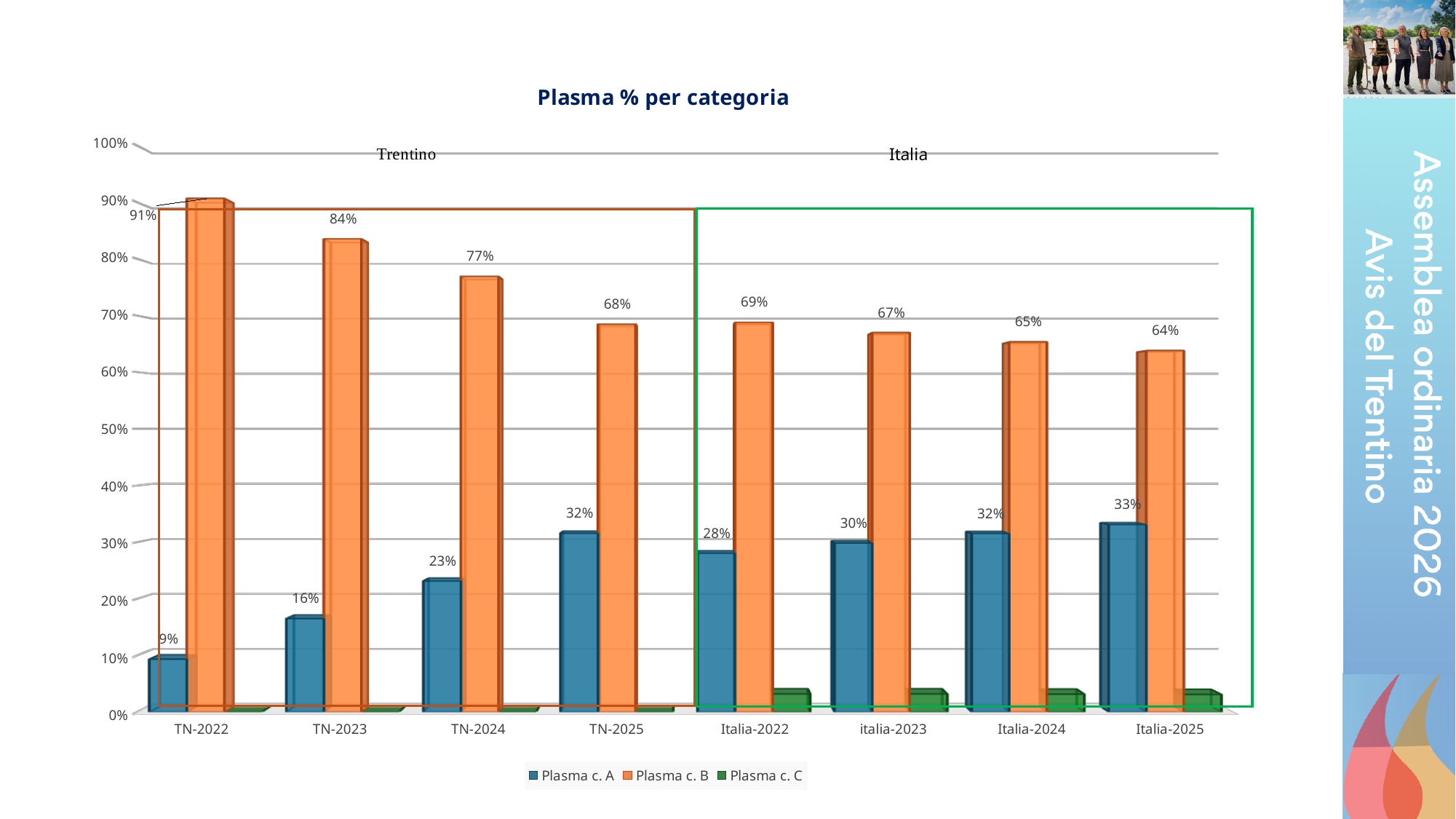
How many series does the legend list? 3 Is the value of Plasma c. C for Italia-2024 greater or less than 10%? less What is the value of Plasma c. A for Italia-2025? 33% Which is larger: Plasma c. A for TN-2024 or Plasma c. A for Italia-2022? Plasma c. A for Italia-2022 What is the difference between Plasma c. B for TN-2022 and Plasma c. B for TN-2025? 23% What type of chart is shown on the slide? bar chart What is the value of Plasma c. B for TN-2022? 91% Does the value of Plasma c. B rise or fall from TN-2022 to TN-2025? fall How many categories are shown on the x axis? 8 What is the title of the chart? Plasma % per categoria Which category has the highest value for Plasma c. B? TN-2022 Which category has the lowest value for Plasma c. A? TN-2022